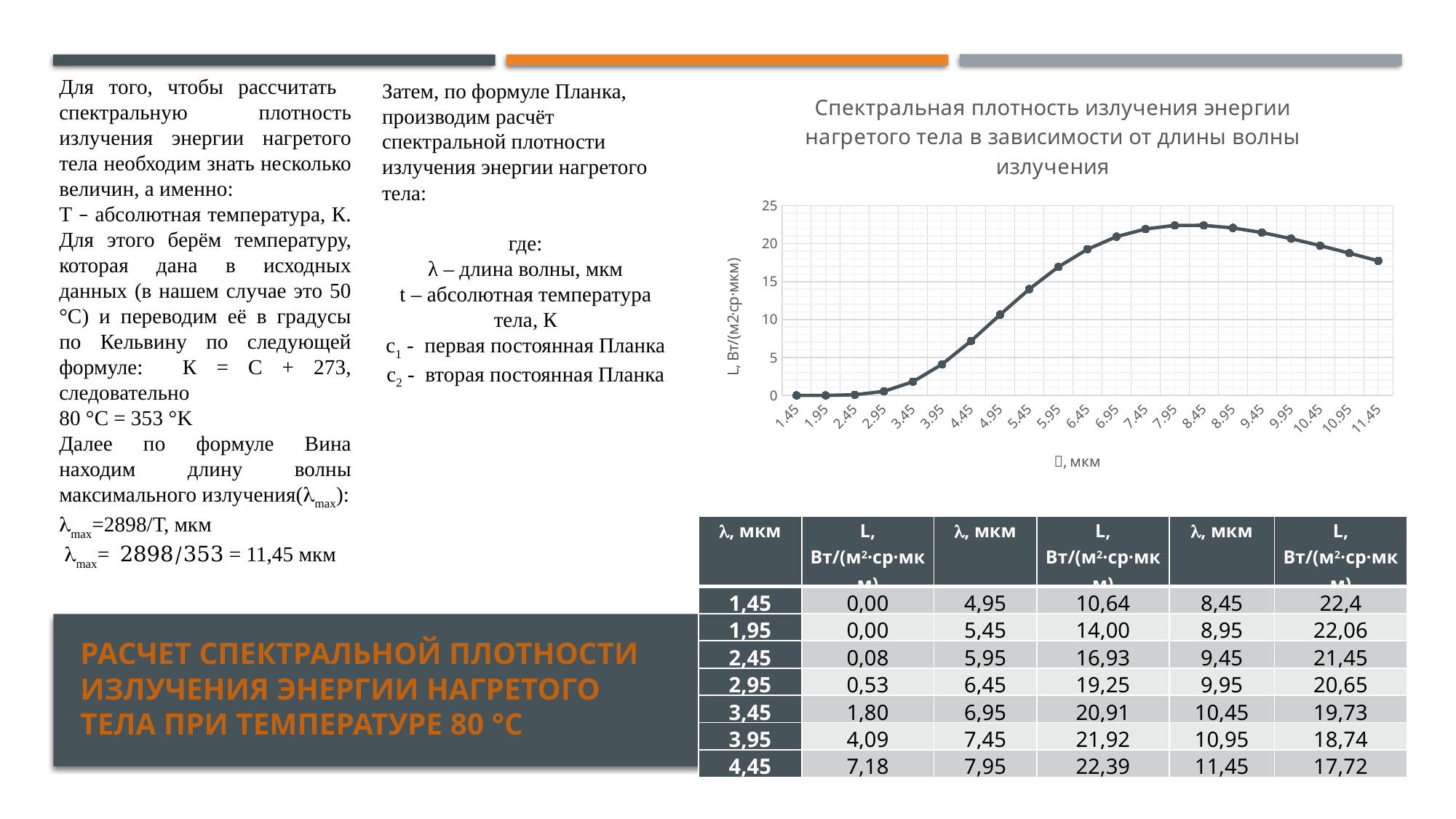
Which has the larger value, λ = 5.95 мкм or λ = 9.95 мкм? 9.95 Do the values rise or fall along the x axis from λ = 1.45 to λ = 7.45 мкм? rise Is the value for λ = 11.45 мкм greater or less than 15? greater Which has the larger value, λ = 3.95 мкм or λ = 10.95 мкм? 10.95 Do the values rise or fall along the x axis from λ = 8.45 to λ = 11.45 мкм? fall Is the value for λ = 6.45 мкм greater or less than 20? less Is the value for λ = 7.45 мкм greater or less than 20? greater How many data points are plotted on the chart? 21 What is the label of the y axis of the chart? L, Вт/(м2·ср·мкм) What kind of chart is shown on the slide? line chart